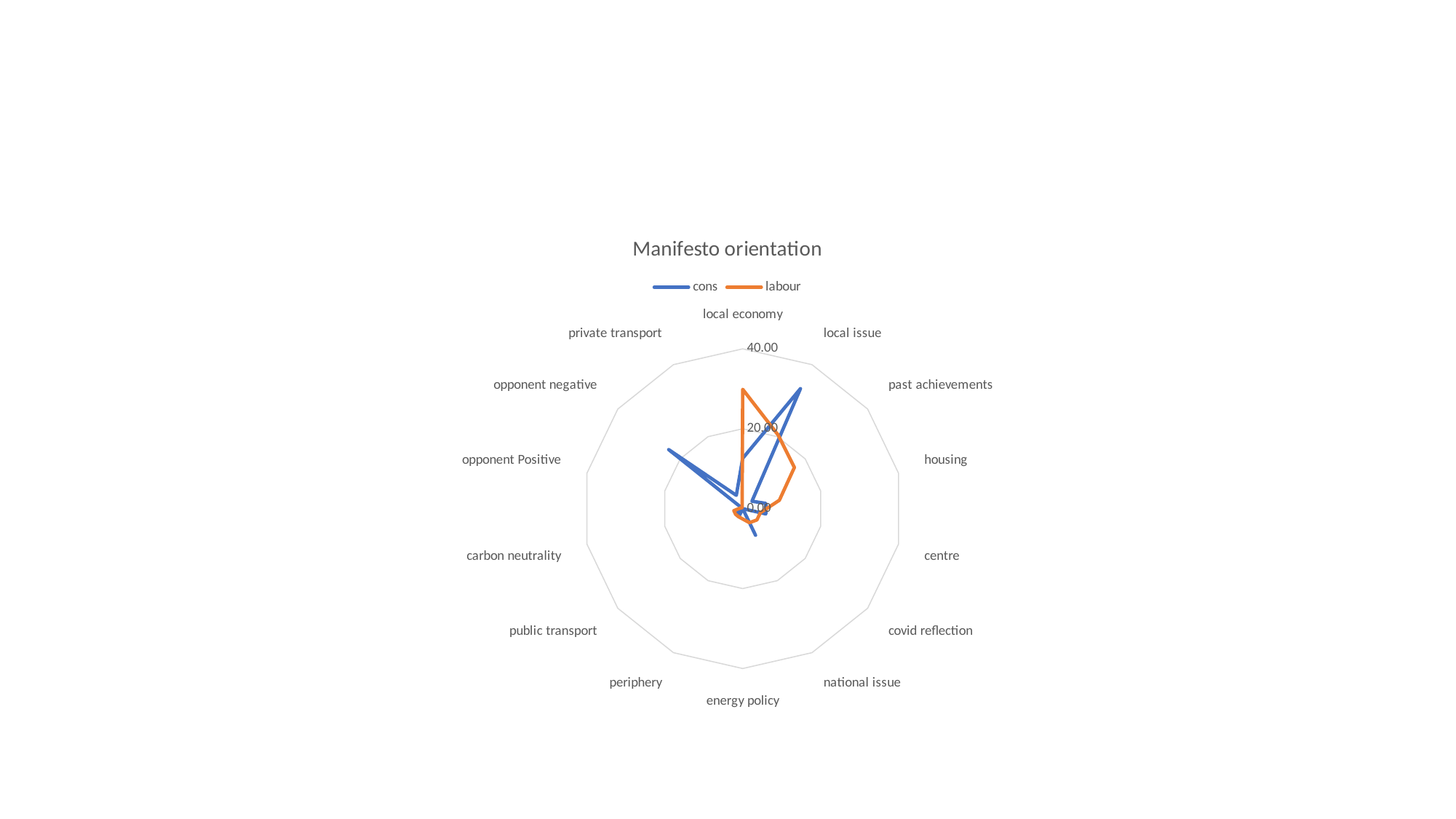
Which series are listed in the legend? cons and labour Is the labour value for housing greater or less than 20.00? less How many categories are plotted around the radar chart? 14 Is the labour value for local economy greater or less than 20.00? greater What kind of chart is shown on the slide? Radar chart For which category does the cons series reach its highest value? local issue What is the title of the chart? Manifesto orientation Is the cons value for local issue greater or less than 20.00? greater How many series does the legend list? 2 For which category does the labour series reach its highest value? local economy Which series has the larger value for local issue, cons or labour? cons Which series has the larger value for opponent negative, cons or labour? cons